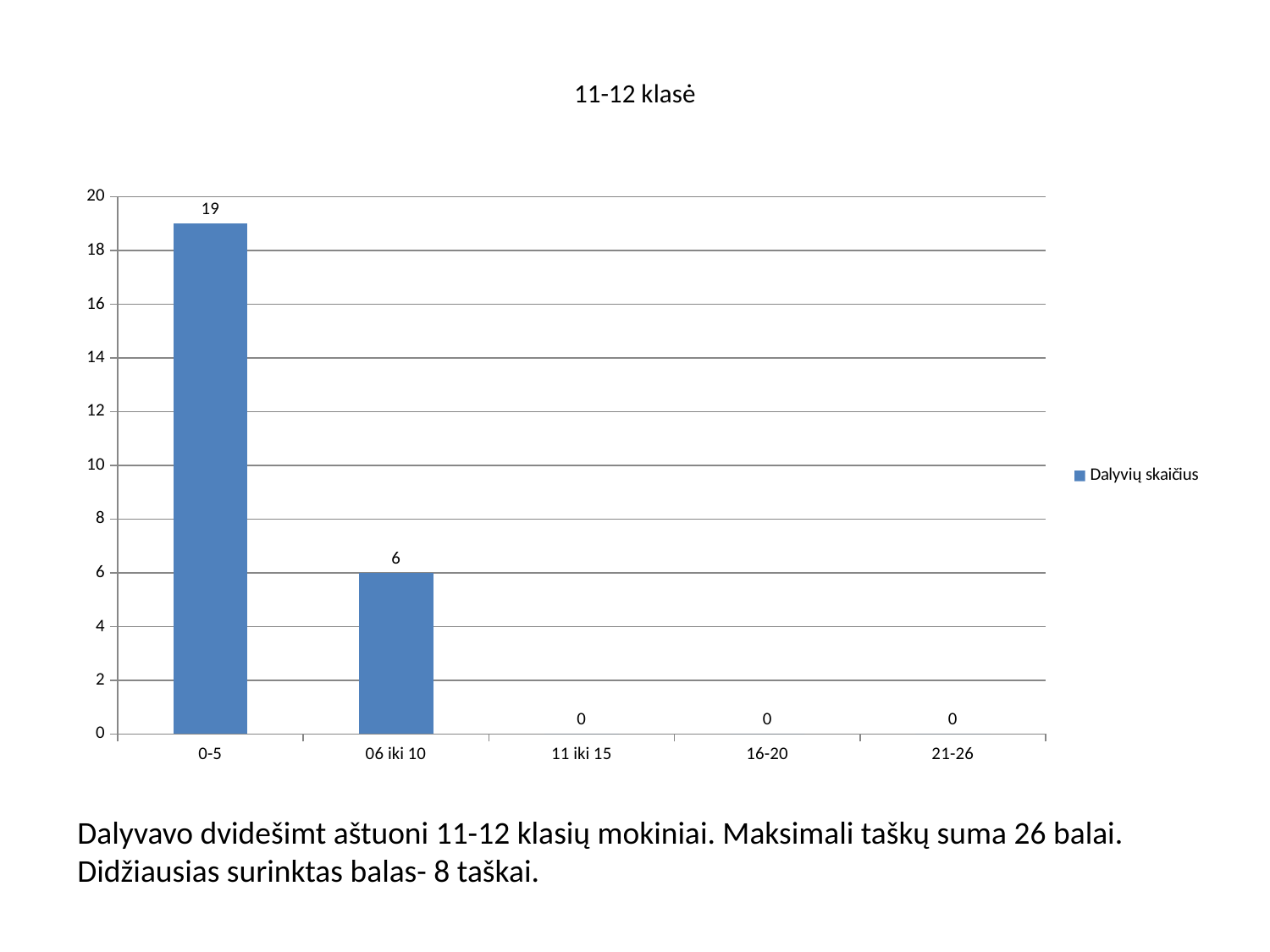
Do the values rise or fall from left to right along the x axis? fall How many categories are shown on the x axis? 5 Which is larger, the value for 0-5 or the value for 06 iki 10? 0-5 What is the value for the 0-5 category? 19 Which category has the highest value? 0-5 What is the value for the 16-20 category? 0 What kind of chart is shown? bar chart How many series does the legend list? 1 What is the difference between the values for 0-5 and 06 iki 10? 13 What is the title of the chart? 11-12 klasė Is the value for 0-5 greater or less than 10? greater What is the value for the 06 iki 10 category? 6